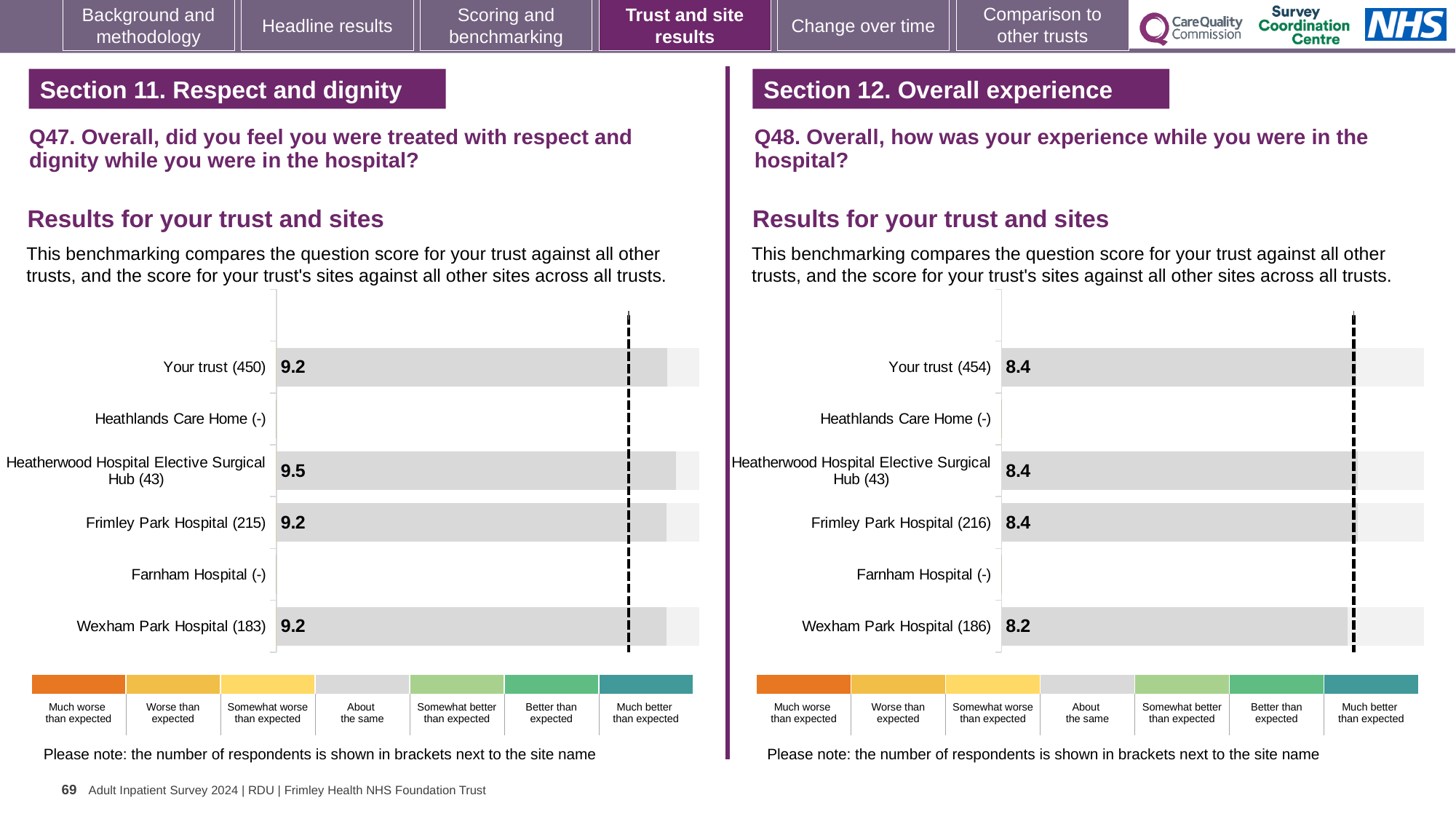
In the Q47 chart on the left, what is the score for Your trust? 9.2 In the Q48 chart on the right, how many respondents are shown in brackets for Your trust? 454 In the Q48 chart on the right, what is the score for Frimley Park Hospital? 8.4 In the Q47 chart on the left, what is the score for Heatherwood Hospital Elective Surgical Hub? 9.5 In the Q47 chart on the left, which site has the highest score? Heatherwood Hospital Elective Surgical Hub What kind of chart is used for the Q47 results on the left? Bar chart In the Q47 chart on the left, what is the difference between the scores for Heatherwood Hospital Elective Surgical Hub and Frimley Park Hospital? 0.3 In the Q48 chart on the right, which site has the lowest score? Wexham Park Hospital In the Q48 chart on the right, what is the difference between the scores for Your trust and Wexham Park Hospital? 0.2 In the Q47 chart on the left, which has the higher score: Heatherwood Hospital Elective Surgical Hub or Wexham Park Hospital? Heatherwood Hospital Elective Surgical Hub In the Q48 chart on the right, what is the score for Wexham Park Hospital? 8.2 How many site rows (including Your trust) are listed in the Q48 chart on the right? 6